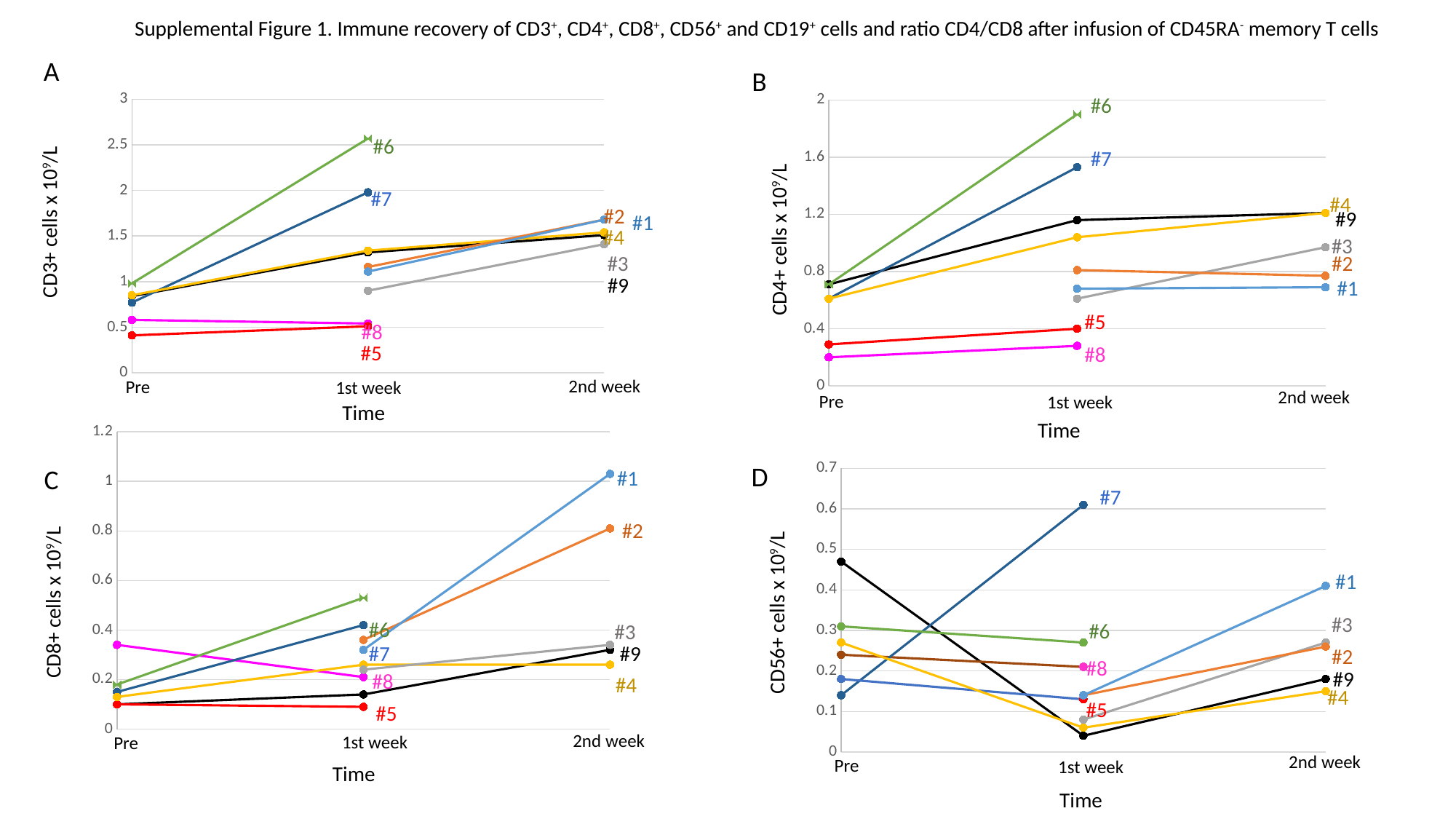
In panel C (CD8+ cells), which patient has the highest value at 2nd week? #1 What is the y-axis label of panel C? CD8+ cells x 10⁹/L In panel B (CD4+ cells), is the value for #8 at Pre greater or less than 0.4? less In panel A (CD3+ cells), which patient has the highest value at 1st week? #6 In panel D (CD56+ cells), does the value for #9 rise or fall from Pre to 1st week? fall What type of chart is panel A? line chart In panel A (CD3+ cells), is the value for #5 at Pre greater or less than 0.5? less In panel A (CD3+ cells), is the value for #6 at 1st week greater or less than 2? greater In panel B (CD4+ cells), which patient has the highest value at 1st week? #6 How many time points are shown on the x axis of panel A? 3